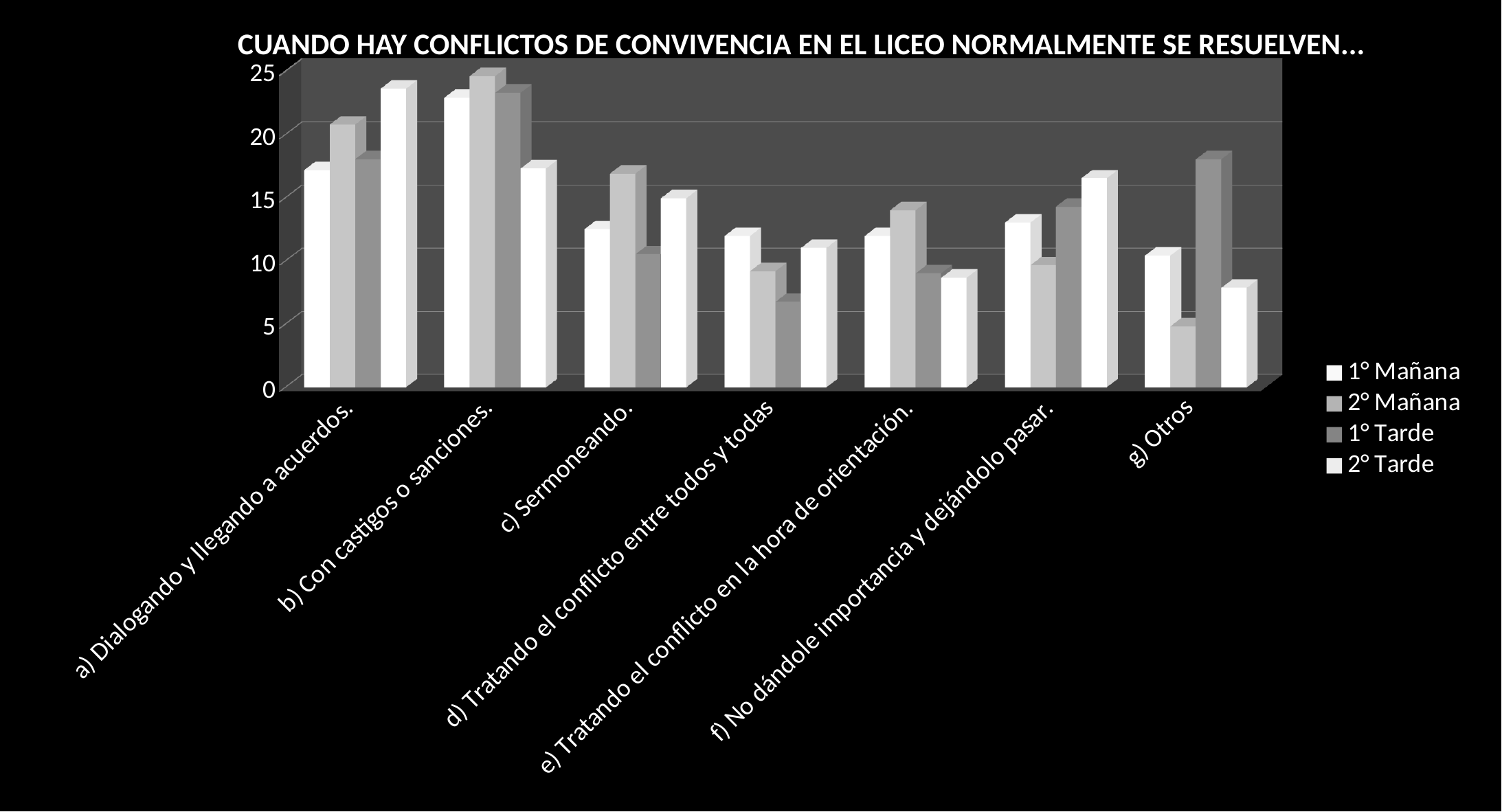
How many categories are shown on the x axis? 7 Which category has the highest value for the 2° Mañana series? b) Con castigos o sanciones. What kind of chart is shown on the slide? Bar chart How many series does the legend list? 4 Which category has the highest value for the 2° Tarde series? a) Dialogando y llegando a acuerdos. For a) Dialogando y llegando a acuerdos., which is larger: the 1° Mañana value or the 2° Tarde value? 2° Tarde Is the 2° Mañana value for b) Con castigos o sanciones. greater or less than 20? greater For g) Otros, which is larger: the 2° Mañana value or the 1° Tarde value? 1° Tarde Which category has the lowest value for the 2° Mañana series? g) Otros Is the 2° Mañana value for g) Otros greater or less than 10? less Is the 1° Tarde value for g) Otros greater or less than 15? greater What is the title of the chart? CUANDO HAY CONFLICTOS DE CONVIVENCIA EN EL LICEO NORMALMENTE SE RESUELVEN…